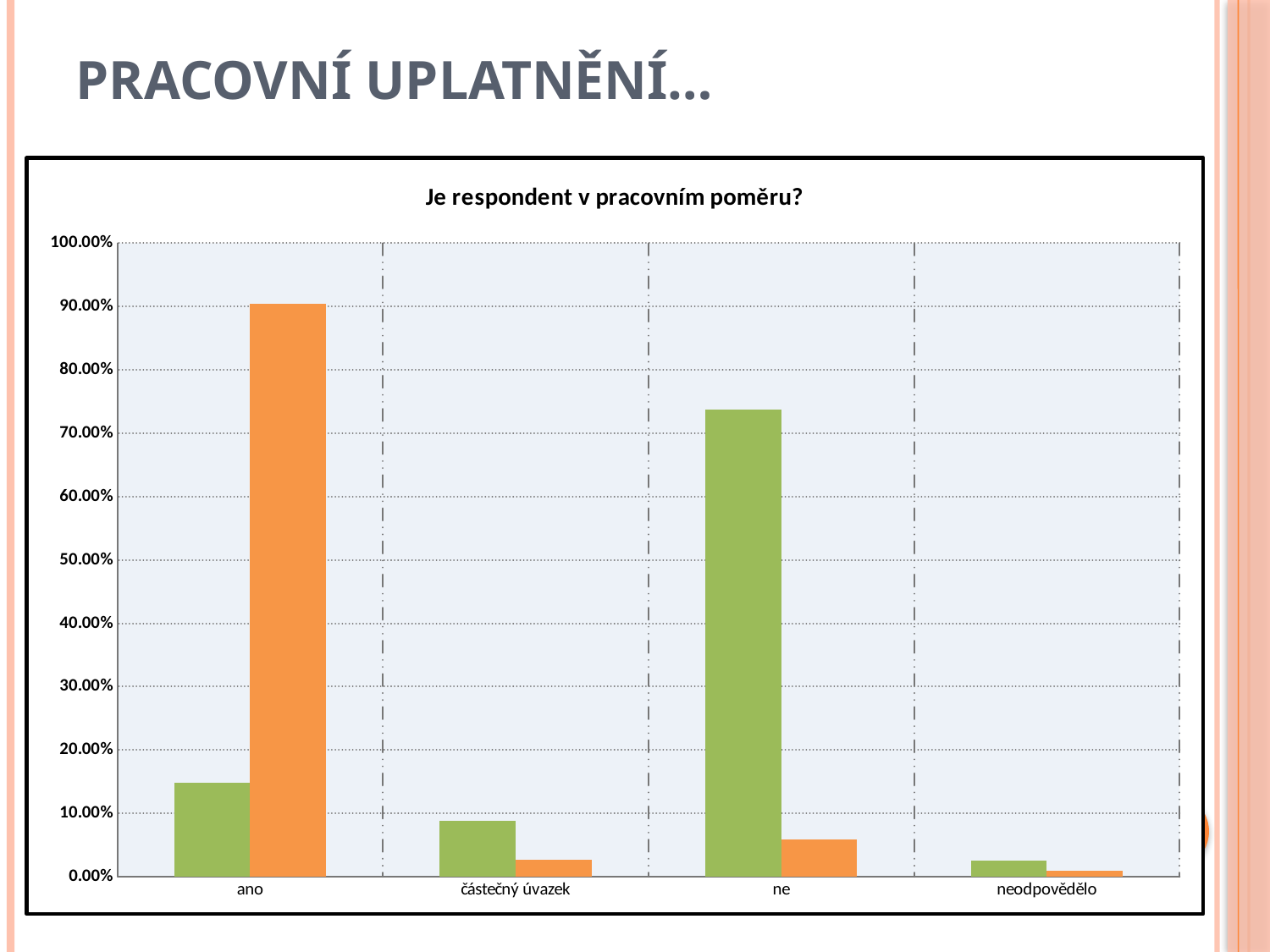
Is the green bar for 'ne' greater or less than 70.00%? greater What is the title of the chart? Je respondent v pracovním poměru? Is the green bar for 'ano' greater or less than 20.00%? less Is the orange bar for 'ano' greater or less than 80.00%? greater Which category has the shortest orange bar? neodpovědělo Which category has the tallest green bar? ne Which category has the tallest orange bar? ano For the category 'ano', which bar is taller, the green one or the orange one? orange What kind of chart is shown on the slide? bar chart How many categories are shown on the x axis of the chart? 4 For the category 'ne', which bar is taller, the green one or the orange one? green